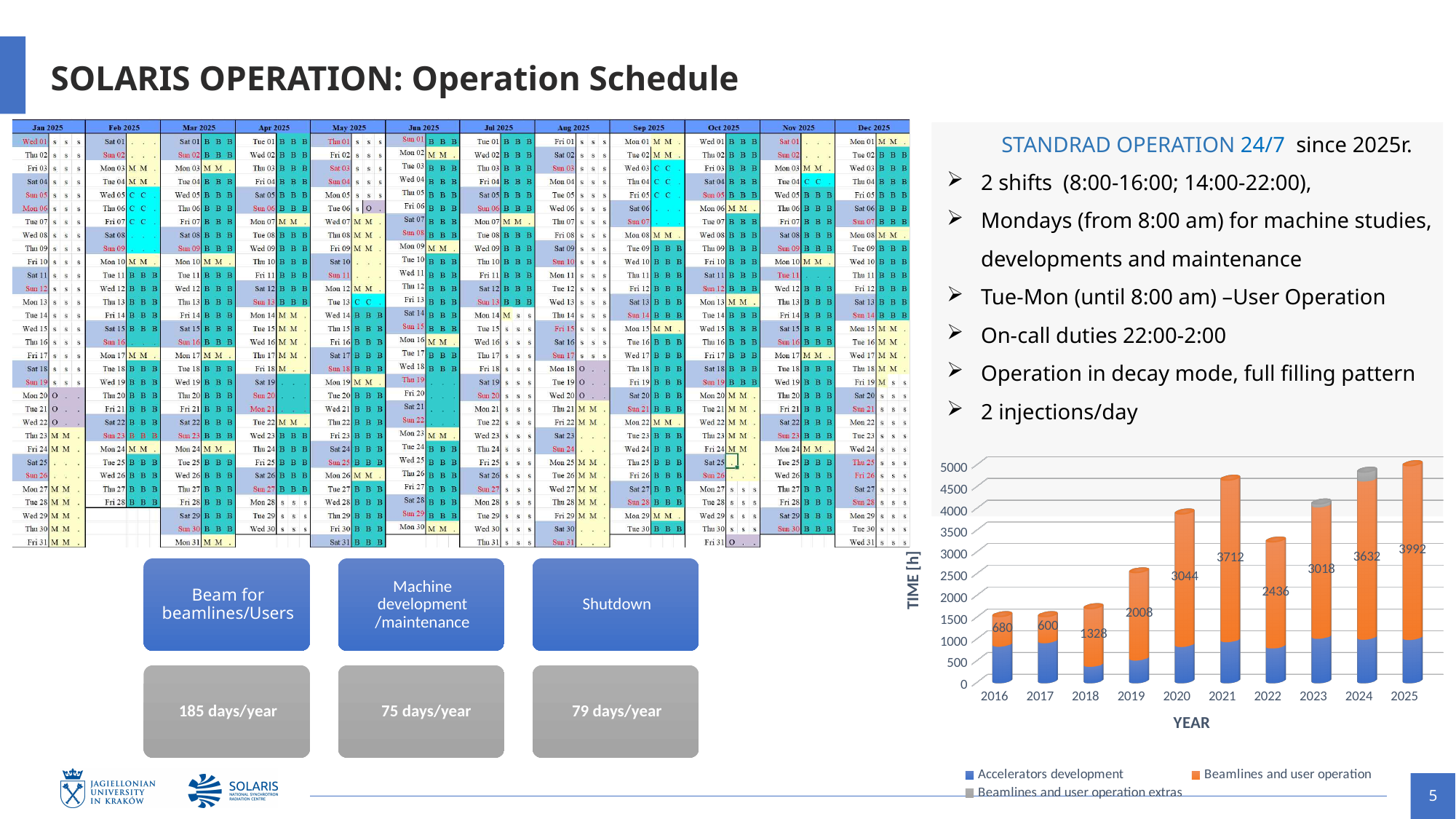
What is the value labelled for Beamlines and user operation in 2025? 3992 What is the difference between the Beamlines and user operation values for 2025 and 2024? 360 Which year has the lowest labelled value for Beamlines and user operation? 2017 What is the title of the vertical axis of the chart? TIME [h] How many series does the chart legend list? 3 What is the value labelled for Beamlines and user operation in 2022? 2436 How many years are shown on the x axis of the chart? 10 Which year has the larger Beamlines and user operation value, 2021 or 2023? 2021 Is the Accelerators development value for 2018 greater or less than 1000? less What is the value labelled for Beamlines and user operation in 2019? 2008 Which year has the highest labelled value for Beamlines and user operation? 2025 What kind of chart is shown on the slide? stacked bar chart